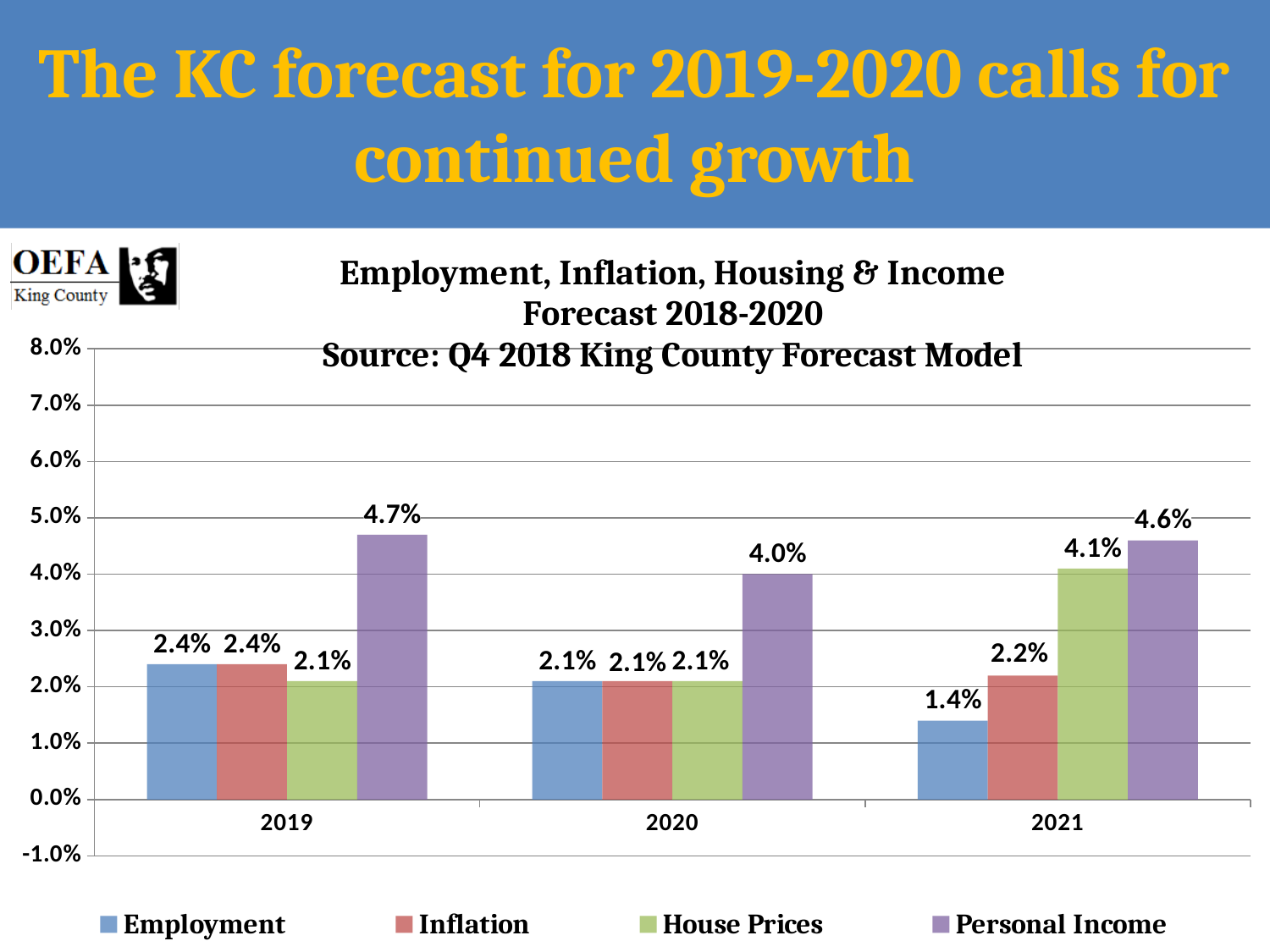
What is the Inflation value for 2020? 2.1% What is the Personal Income value for 2019? 4.7% Which series has the highest value in 2020? Personal Income Does the Employment value rise or fall from 2019 to 2021? Fall What is the Employment value for 2021? 1.4% Which series has the lowest value in 2021? Employment What is the House Prices value for 2021? 4.1% What is the difference between Personal Income and House Prices in 2019? 2.6% What kind of chart is shown? Bar chart How many years are shown on the x axis? 3 How many series does the legend list? 4 Which is larger, Personal Income in 2019 or Personal Income in 2021? Personal Income in 2019